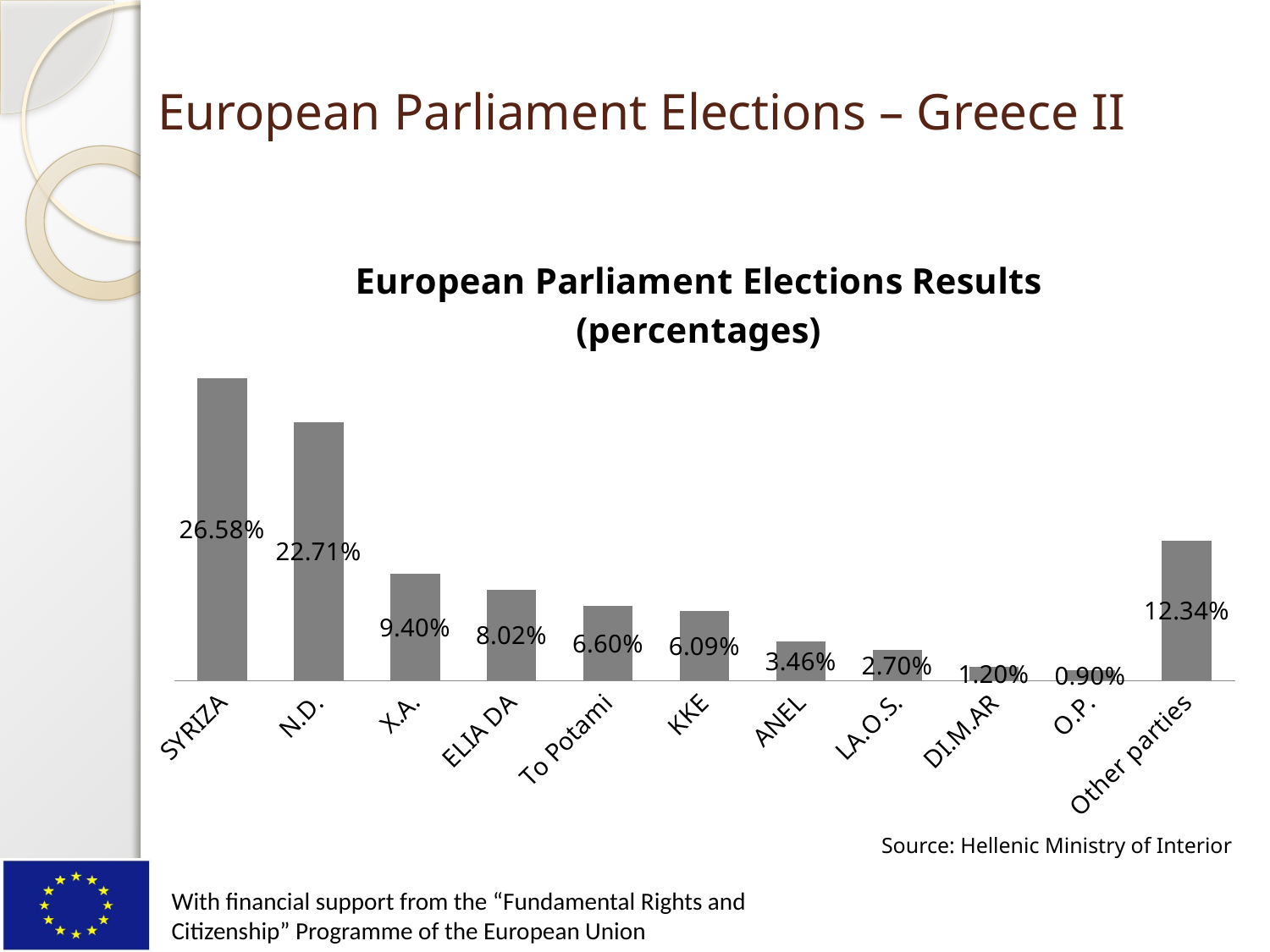
How many categories are shown on the x axis of the chart? 11 What percentage is shown for N.D.? 22.71% What percentage is shown for To Potami? 6.60% What percentage did SYRIZA receive in the European Parliament Elections Results chart? 26.58% Do the values generally rise or fall from SYRIZA to O.P. along the x axis? Fall What source is cited for the chart data? Hellenic Ministry of Interior Which has a higher percentage, KKE or ANEL? KKE What kind of chart is shown on the slide? Bar chart Which party has the highest percentage in the chart? SYRIZA What is the difference in percentage points between SYRIZA and N.D.? 3.87 Which category has the lowest percentage in the chart? O.P. What percentage is shown for Other parties? 12.34%